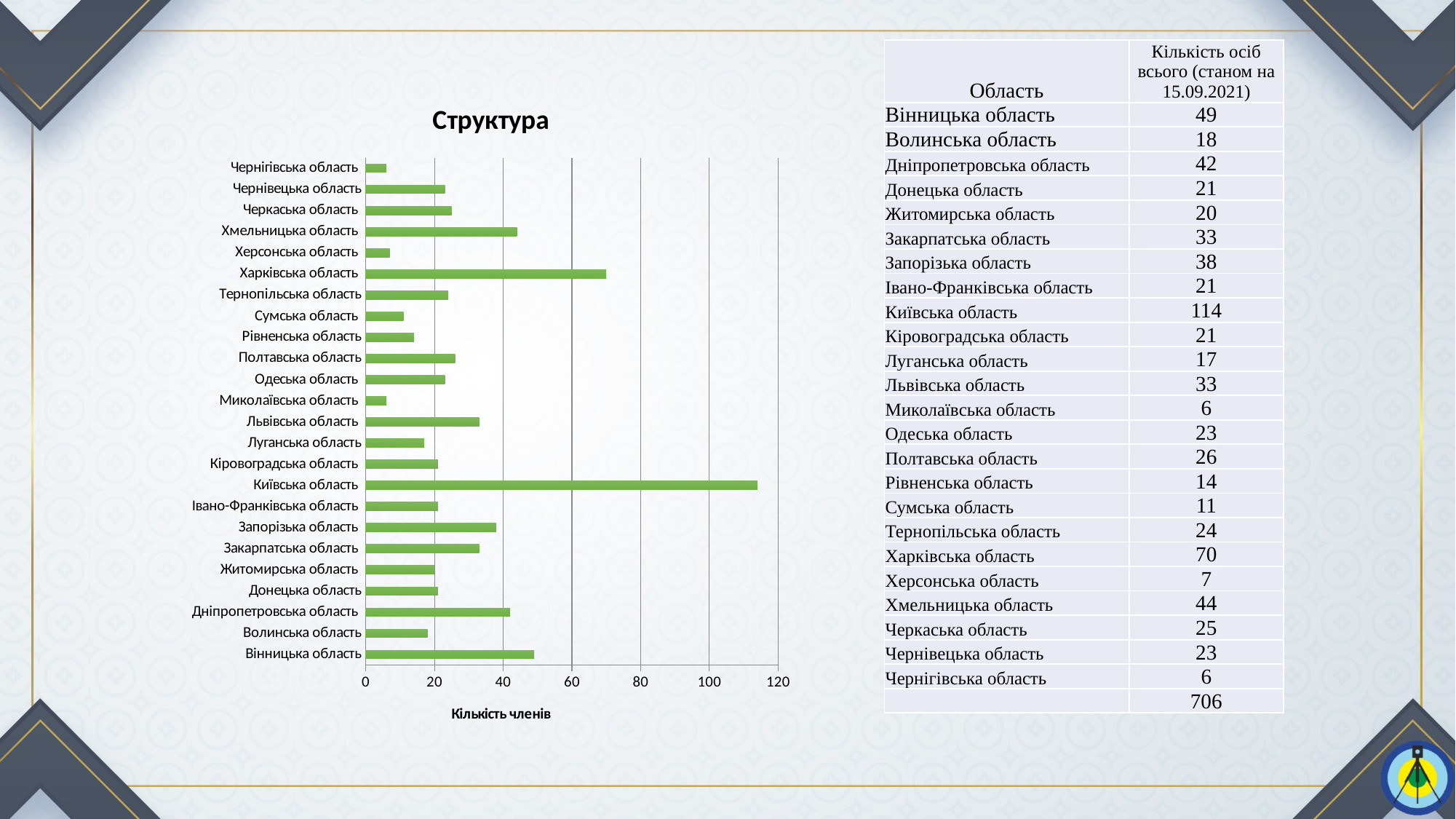
Which is larger, the value for Запорізька область or the value for Закарпатська область? Запорізька область What is the title of the chart? Структура Is the value for Харківська область greater or less than 60? greater How many regions (categories) are plotted in the chart? 24 What is the value for Харківська область? 70 What kind of chart is shown on the slide? bar chart What is the value for Київська область? 114 What is the difference between the values for Київська область and Харківська область? 44 Which region has the highest value in the chart? Київська область What is the value for Вінницька область? 49 Is the value for Хмельницька область greater or less than 40? greater What is the label of the horizontal axis? Кількість членів